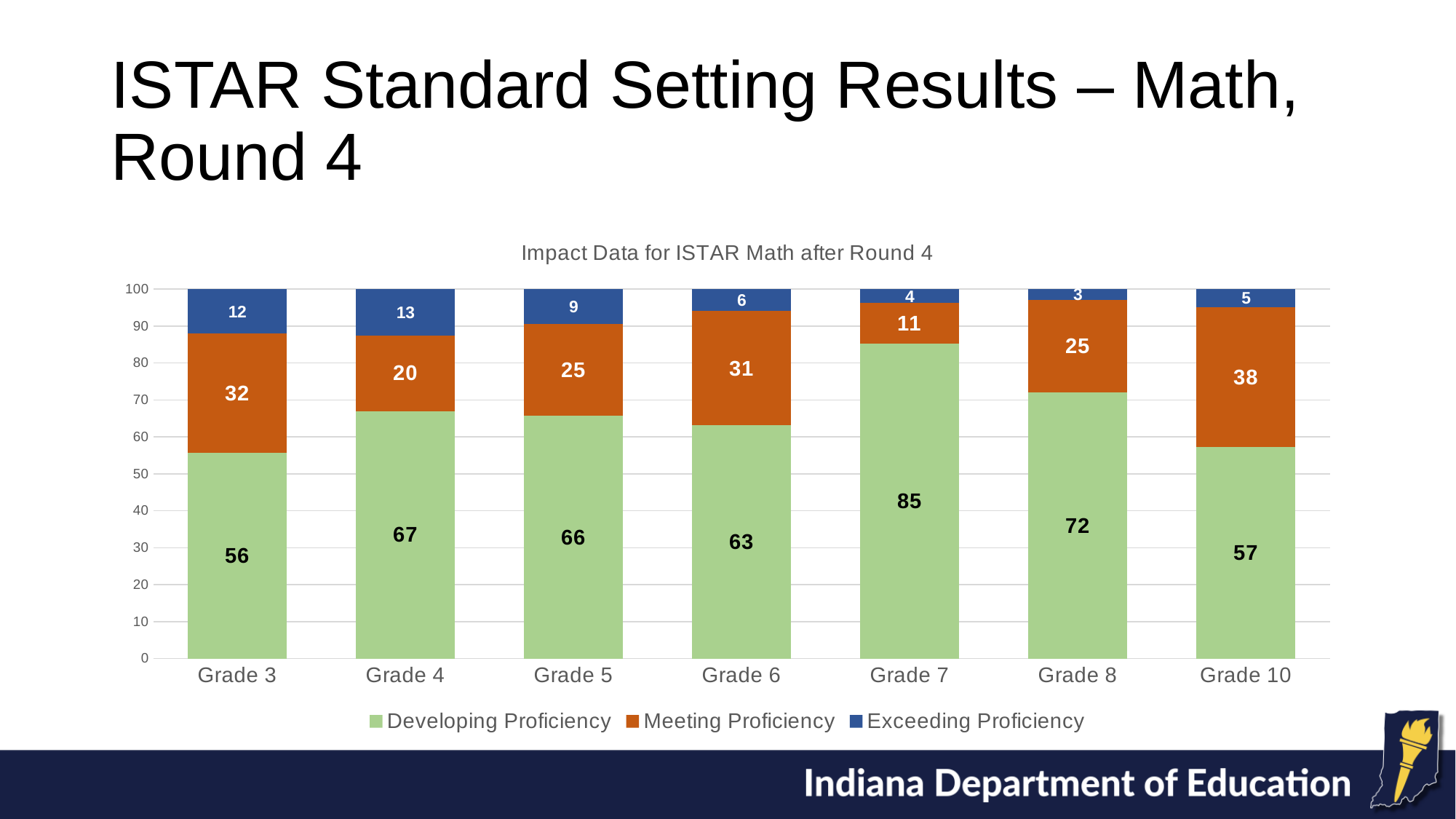
What is the difference between the Meeting Proficiency values for Grade 10 and Grade 4? 18 What kind of chart is shown on the slide? Stacked bar chart What is the total of the stacked bar for Grade 6? 100 How many series does the legend list? 3 What is the Meeting Proficiency value for Grade 10? 38 Which grade has the lowest Exceeding Proficiency value? Grade 8 How many grades are shown on the x axis? 7 Which grade has the highest Developing Proficiency value? Grade 7 What is the title of the chart? Impact Data for ISTAR Math after Round 4 What is the Exceeding Proficiency value for Grade 4? 13 What is the Developing Proficiency value for Grade 7? 85 Which is larger, the Developing Proficiency value for Grade 3 or for Grade 10? Grade 10